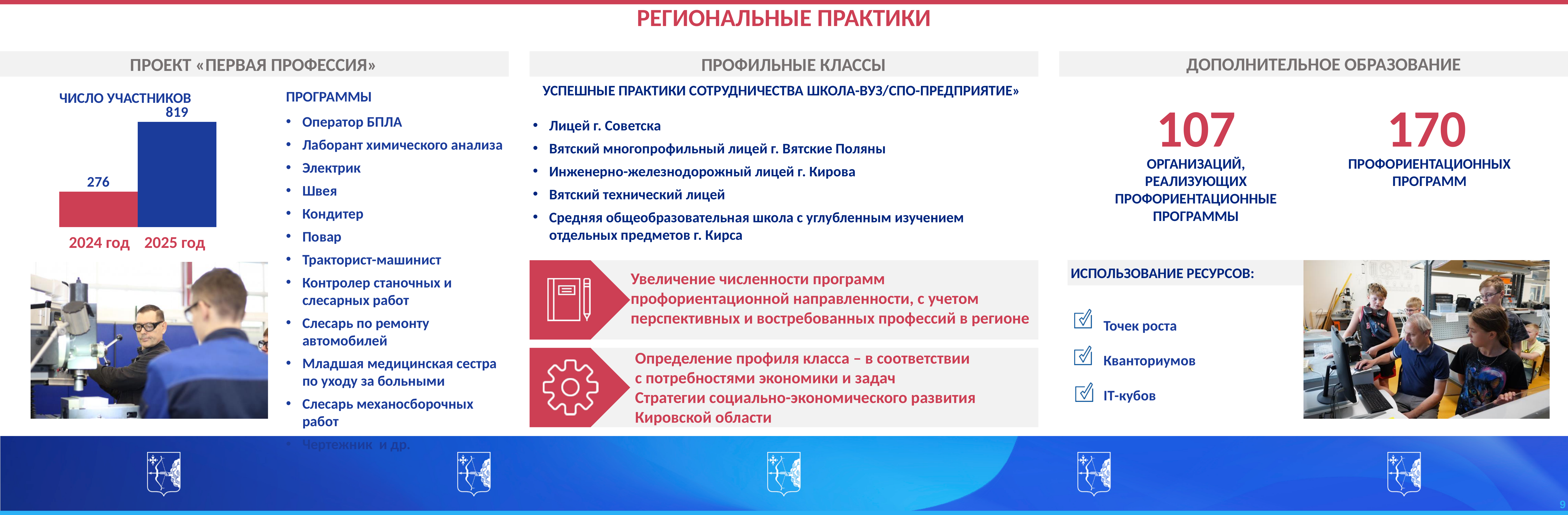
Which year has the highest number of participants in the ЧИСЛО УЧАСТНИКОВ chart? 2025 год Which year has the lowest number of participants in the ЧИСЛО УЧАСТНИКОВ chart? 2024 год In the ЧИСЛО УЧАСТНИКОВ chart, which is larger: the value for 2024 год or for 2025 год? 2025 год What is the value for 2024 год in the ЧИСЛО УЧАСТНИКОВ chart? 276 What kind of chart is the ЧИСЛО УЧАСТНИКОВ chart? bar chart What is the title of the bar chart on the slide? ЧИСЛО УЧАСТНИКОВ How many categories are shown in the ЧИСЛО УЧАСТНИКОВ chart? 2 What is the difference between the 2025 год and 2024 год values in the ЧИСЛО УЧАСТНИКОВ chart? 543 Do the values in the ЧИСЛО УЧАСТНИКОВ chart rise or fall from 2024 год to 2025 год? rise What colour is the bar for 2024 год in the ЧИСЛО УЧАСТНИКОВ chart? red What is the value for 2025 год in the ЧИСЛО УЧАСТНИКОВ chart? 819